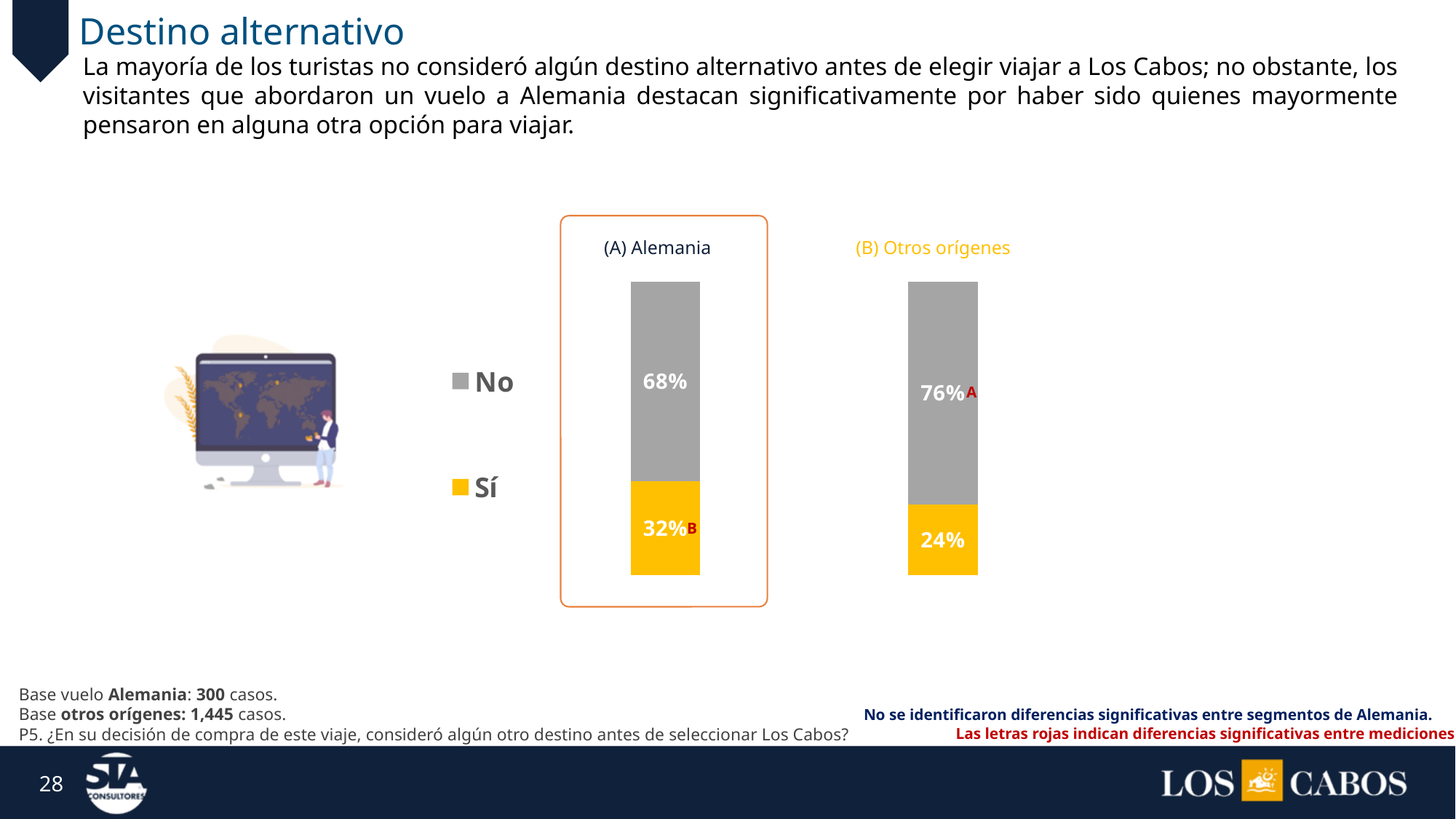
What is the difference in the "Sí" percentage between (A) Alemania and (B) Otros orígenes? 8 percentage points What percentage of (A) Alemania respondents answered "No"? 68% What type of chart is shown on the slide? Stacked bar chart How many series does the legend list? 2 Which group has the higher "Sí" percentage, (A) Alemania or (B) Otros orígenes? (A) Alemania What is the difference in the "No" percentage between (B) Otros orígenes and (A) Alemania? 8 percentage points Which group has the higher "No" percentage, (A) Alemania or (B) Otros orígenes? (B) Otros orígenes What percentage of (A) Alemania respondents answered "Sí"? 32% What percentage of (B) Otros orígenes respondents answered "Sí"? 24% How many bars (groups) are shown in the chart? 2 What is the total of the stacked bar for (A) Alemania? 100% What percentage of (B) Otros orígenes respondents answered "No"? 76%